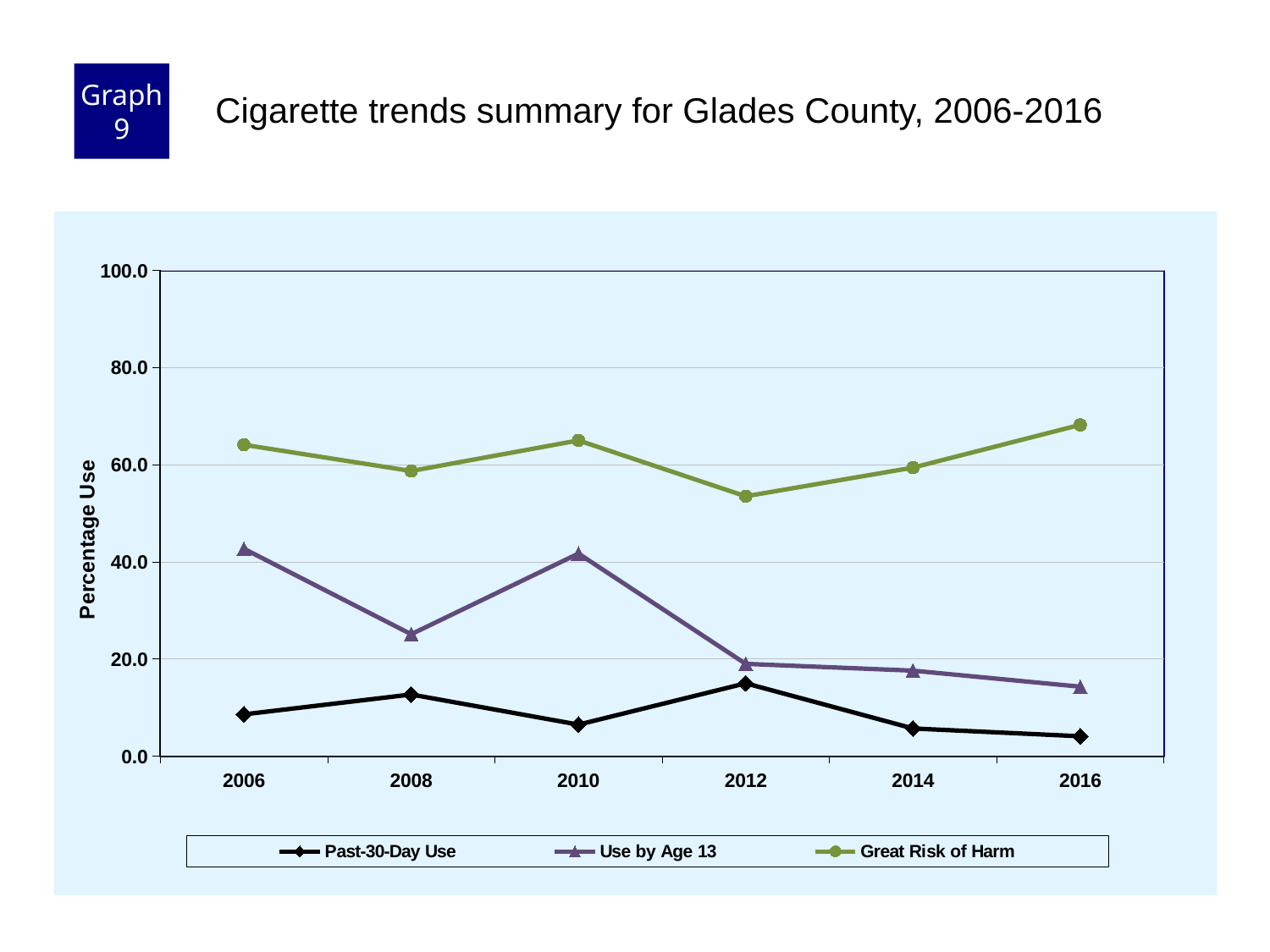
Is the value for Past-30-Day Use in 2012 greater or less than 20.0? less Does the Use by Age 13 series overall rise or fall from 2006 to 2016? Fall How many years are plotted along the x axis? 6 What is the label on the y axis? Percentage Use What kind of chart is shown on the slide? Line chart Which is larger for Use by Age 13: the value in 2006 or the value in 2008? 2006 Which year has the lowest value for Use by Age 13? 2016 How many series does the legend list? 3 Is the value for Use by Age 13 in 2006 greater or less than 40.0? greater Which year has the lowest value for Great Risk of Harm? 2012 Is the value for Great Risk of Harm in 2012 greater or less than 60.0? less Which year has the highest value for Past-30-Day Use? 2012